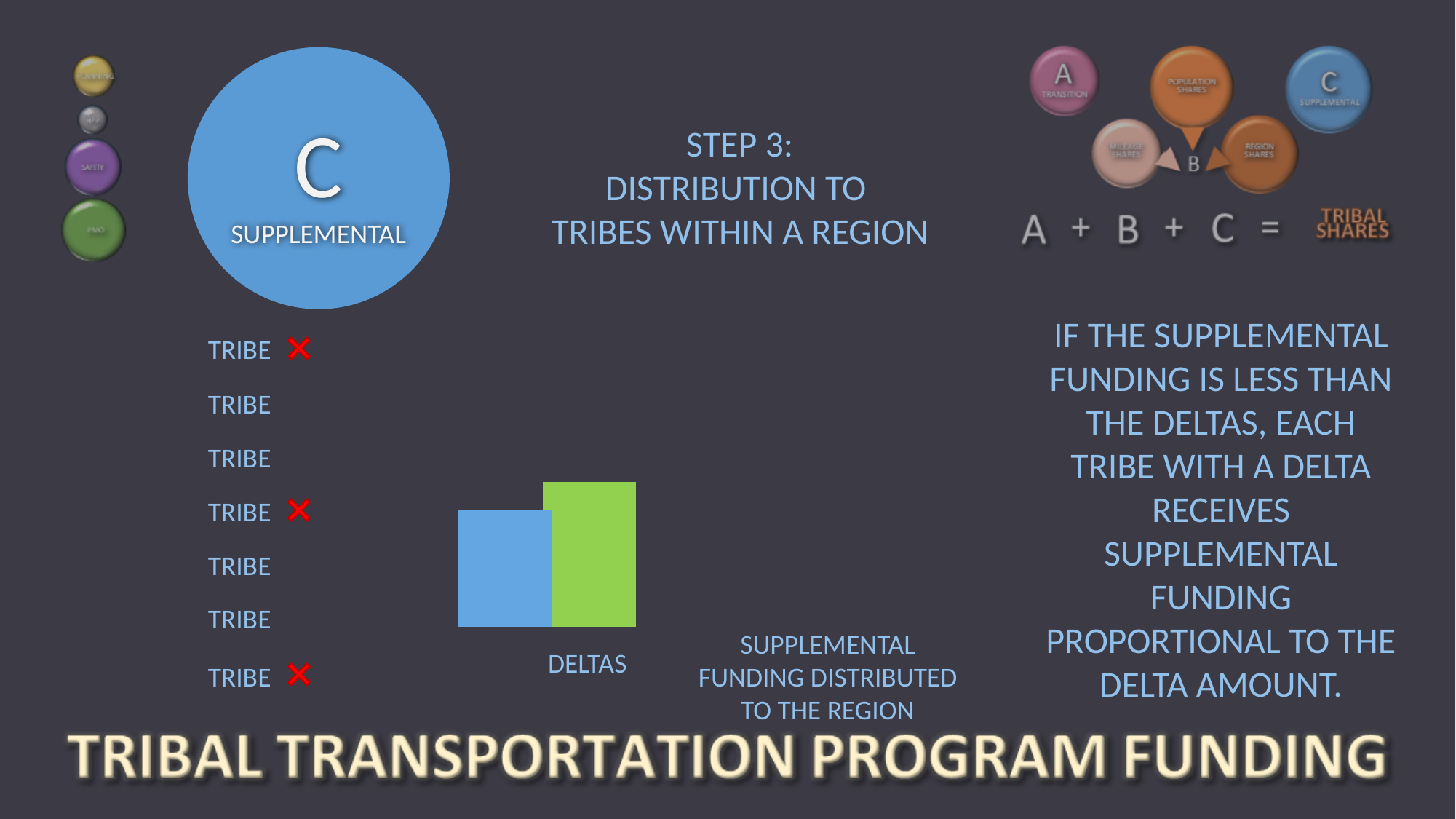
What colour is the bar labelled DELTAS in the chart in the lower middle of the slide? green In the chart next to the label DELTAS, which bar is shorter, the blue bar or the green bar? the blue bar What two colours are the bars in the chart in the lower middle of the slide? blue and green How many bars are plotted in the chart next to the label DELTAS? 2 In the chart next to the label DELTAS, which bar is taller, the blue bar or the green bar? the green bar What kind of chart is shown in the lower middle of the slide, next to the label DELTAS? bar chart